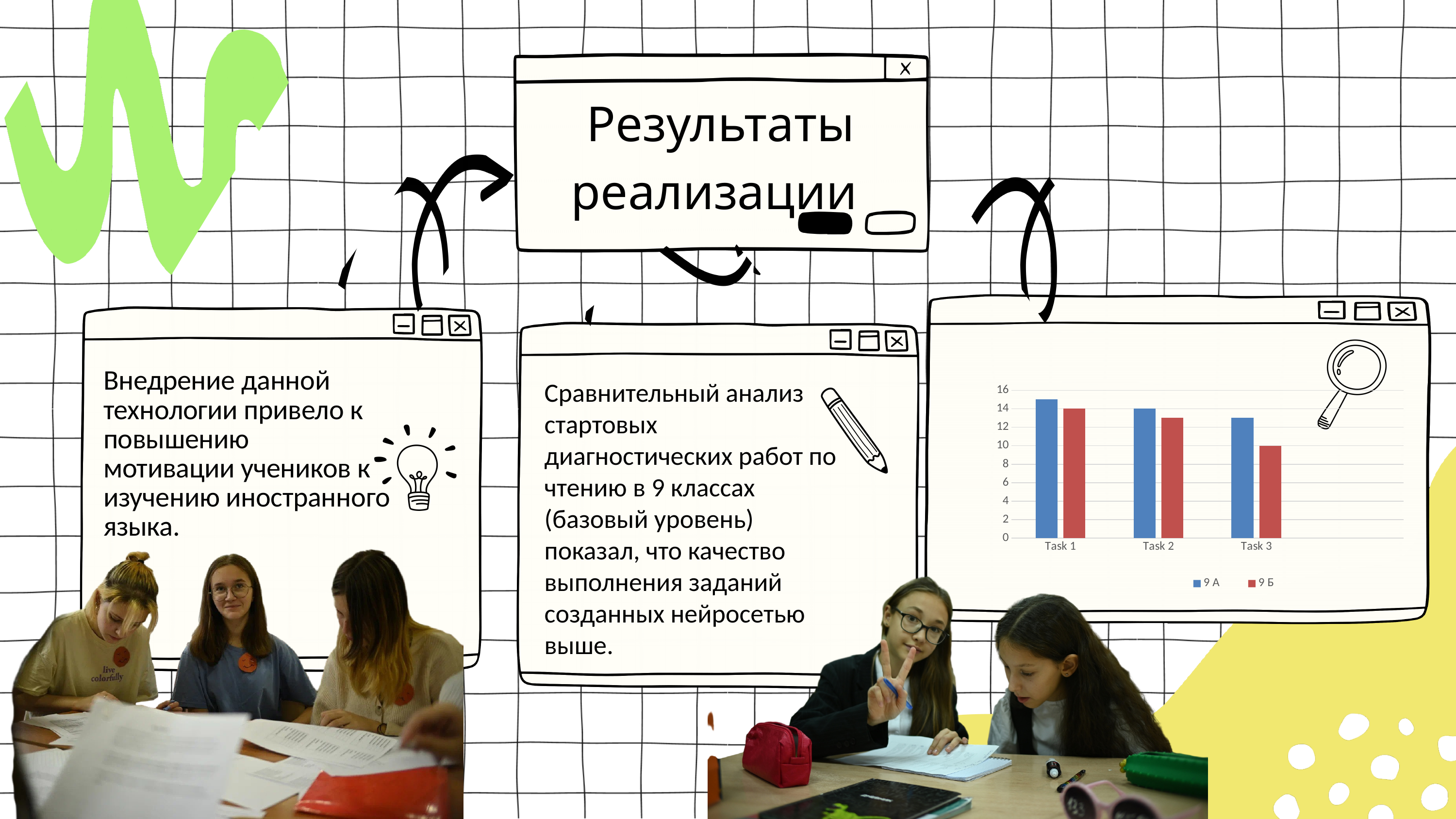
How many task categories are shown on the x axis of the chart? 3 For which task is the 9 А value highest? Task 1 What is the value for 9 Б on Task 3? 10 Which colour represents the 9 А series in the chart? blue For which task is the 9 Б value lowest? Task 3 Do the 9 Б values rise or fall from Task 1 to Task 3? fall What kind of chart is shown on the slide? bar chart On Task 3, which series has the larger value, 9 А or 9 Б? 9 А How many series does the chart legend list? 2 Is the value for 9 Б on Task 3 greater or less than 12? less What are the two series named in the chart legend? 9 А and 9 Б Is the value for 9 А on Task 1 greater or less than 12? greater